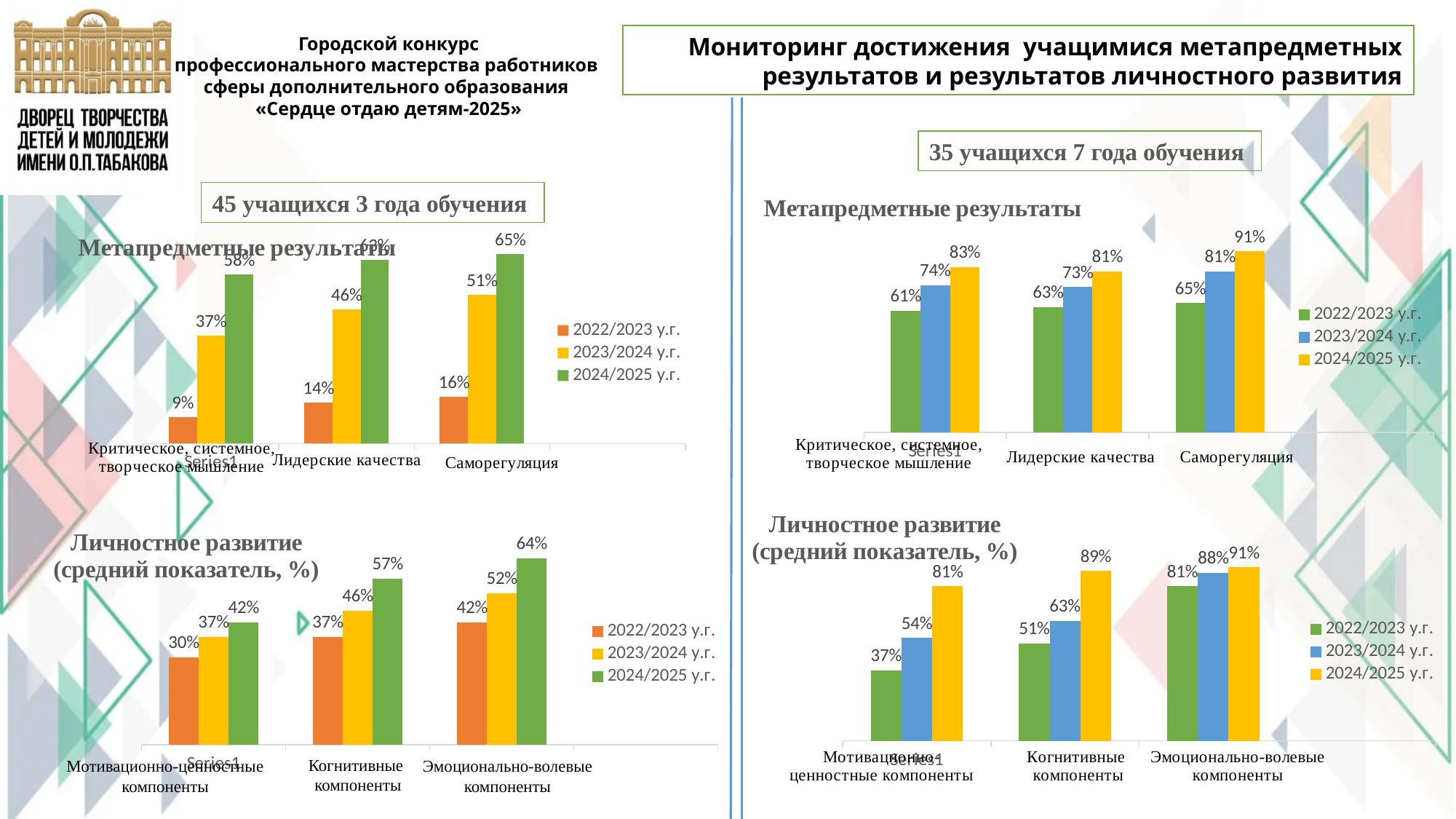
In the top-right chart (Метапредметные результаты, 35 учащихся 7 года обучения), how many series does the legend list? 3 In the bottom-right chart (Личностное развитие, 35 учащихся 7 года обучения), what is the value for Мотивационно-ценностные компоненты in 2023/2024 у.г.? 54% In the top-right chart (Метапредметные результаты, 35 учащихся 7 года обучения), which category has the lowest value for 2022/2023 у.г.? Критическое, системное, творческое мышление In the top-left chart (Метапредметные результаты, 45 учащихся 3 года обучения), what is the difference between the 2023/2024 у.г. and 2022/2023 у.г. values for Лидерские качества? 32% What kind of chart is the bottom-right chart (Личностное развитие, 35 учащихся 7 года обучения)? bar chart In the bottom-left chart (Личностное развитие, 45 учащихся 3 года обучения), do the values for Мотивационно-ценностные компоненты rise or fall from 2022/2023 у.г. to 2024/2025 у.г.? rise In the bottom-left chart (Личностное развитие, 45 учащихся 3 года обучения), what is the value for Когнитивные компоненты in 2023/2024 у.г.? 46% In the top-left chart (Метапредметные результаты, 45 учащихся 3 года обучения), what is the value for Саморегуляция in 2024/2025 у.г.? 65% In the bottom-left chart (Личностное развитие, 45 учащихся 3 года обучения), which category has the highest value for 2024/2025 у.г.? Эмоционально-волевые компоненты In the bottom-right chart (Личностное развитие, 35 учащихся 7 года обучения), which is larger: the 2024/2025 у.г. value for Когнитивные компоненты or the 2024/2025 у.г. value for Мотивационно-ценностные компоненты? Когнитивные компоненты In the top-left chart (Метапредметные результаты, 45 учащихся 3 года обучения), what is the value for Критическое, системное, творческое мышление in 2022/2023 у.г.? 9% In the top-right chart (Метапредметные результаты, 35 учащихся 7 года обучения), what is the value for Саморегуляция in 2024/2025 у.г.? 91%